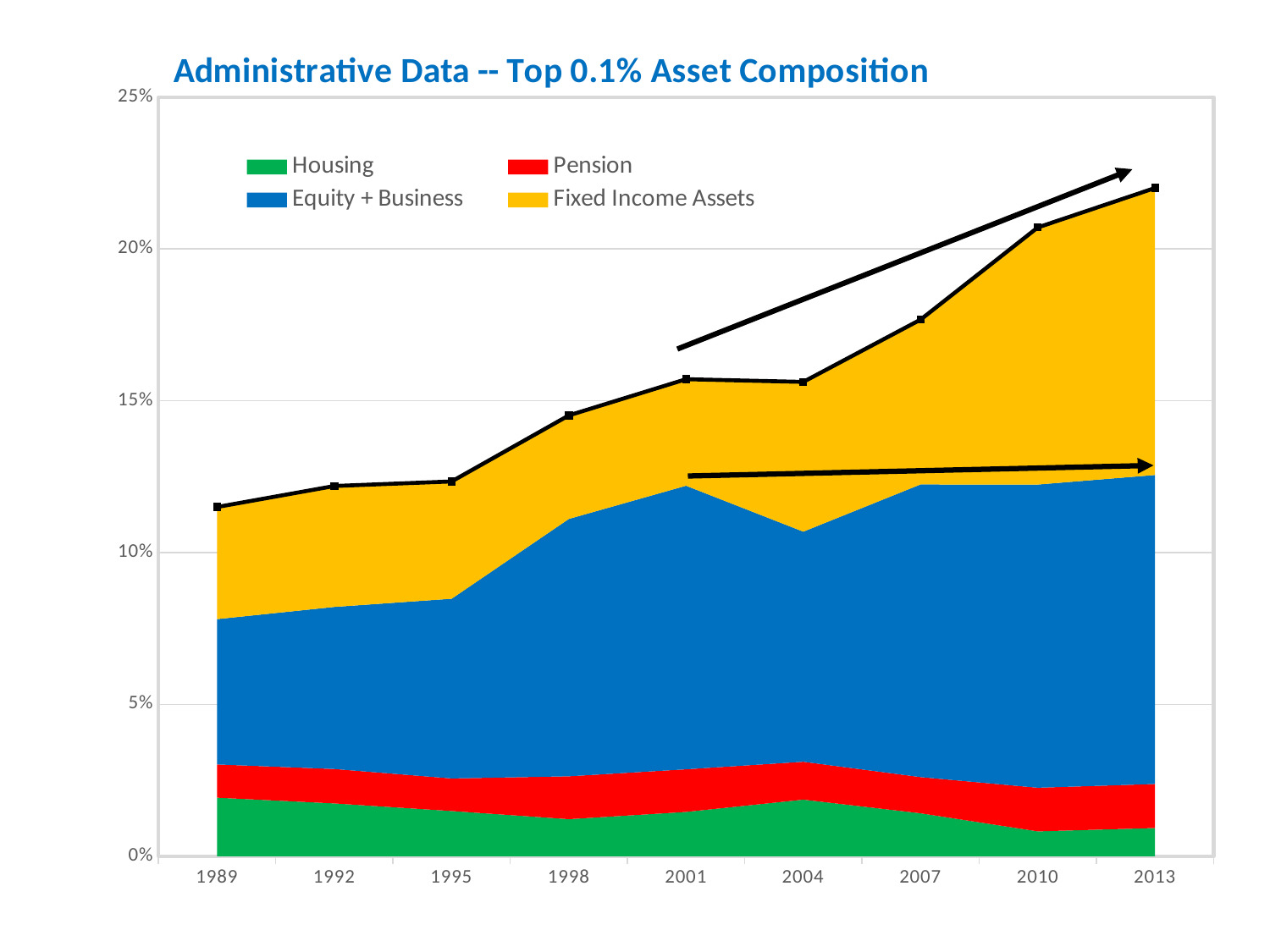
What is the title of the chart? Administrative Data -- Top 0.1% Asset Composition Which colour represents Fixed Income Assets in the legend? Yellow How many years are shown along the x axis? 9 Which series is the largest component of the stack in 2013? Equity + Business Is the total of all asset categories in 2013 greater or less than 20%? greater Does the total of all asset categories rise or fall from 1989 to 2013? Rise Is the total of all asset categories in 1989 greater or less than 15%? less How many series does the legend list? 4 Is the total of all asset categories in 2007 greater or less than 15%? greater What kind of chart is shown on the slide? Stacked area chart In which year is the total of all asset categories highest? 2013 In which year is the total of all asset categories lowest? 1989